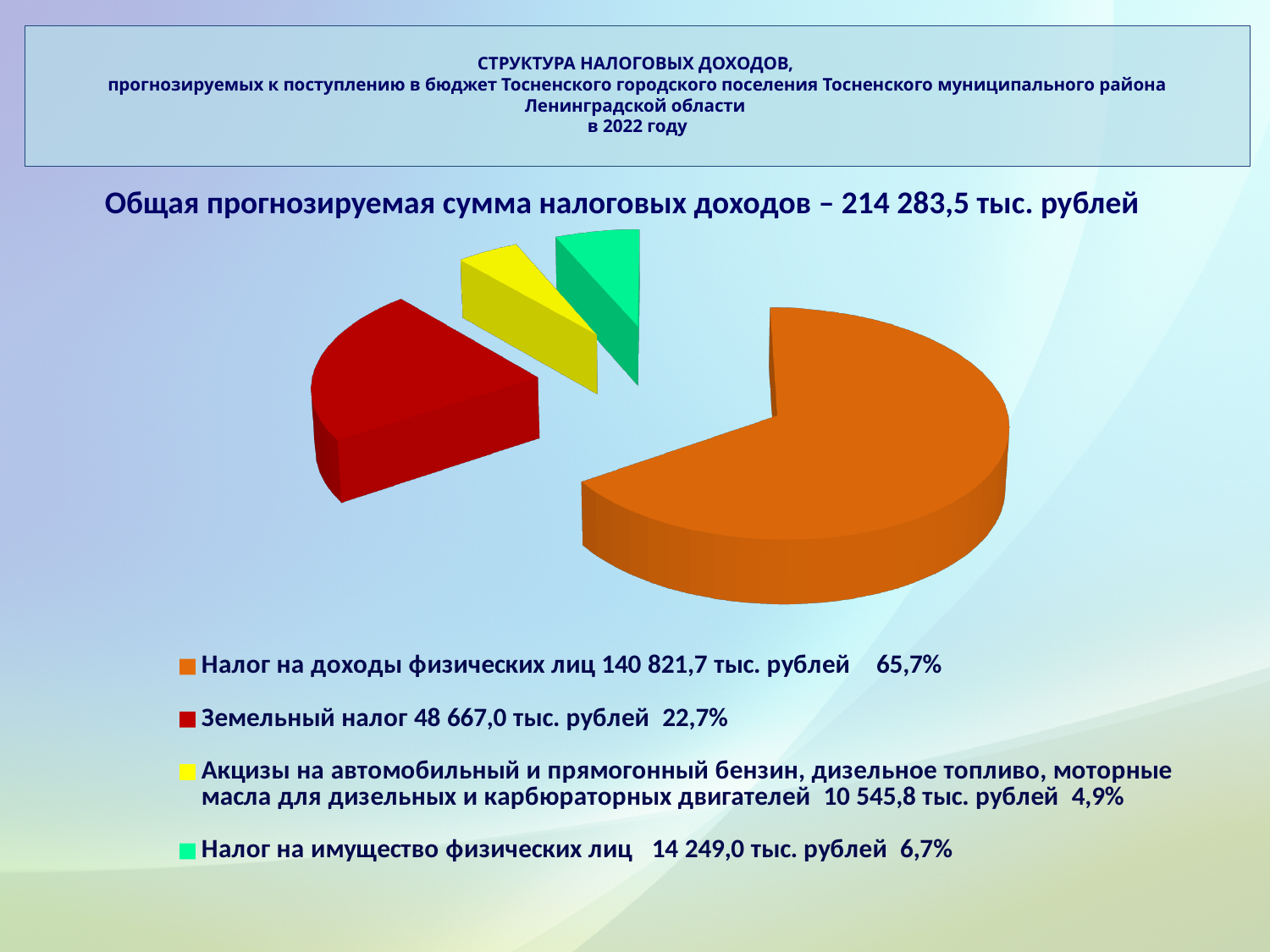
What share of the pie does Земельный налог represent? 22,7% What is the forecast amount for Налог на доходы физических лиц? 140 821,7 тыс. рублей Which category has the smallest share of the pie? Акцизы на автомобильный и прямогонный бензин, дизельное топливо, моторные масла для дизельных и карбюраторных двигателей What is the forecast amount for Налог на имущество физических лиц? 14 249,0 тыс. рублей What type of chart is shown on the slide? Pie chart Which is larger: Земельный налог or Налог на имущество физических лиц? Земельный налог How many slices does the pie chart have? 4 What is the difference in тыс. рублей between Налог на доходы физических лиц and Земельный налог? 92 154,7 тыс. рублей What share of the pie do Акцизы на автомобильный и прямогонный бензин, дизельное топливо, моторные масла represent? 4,9% What colour is the slice for Земельный налог? Red Which category has the largest share of the pie? Налог на доходы физических лиц What is the total forecast sum of tax revenues stated on the slide? 214 283,5 тыс. рублей